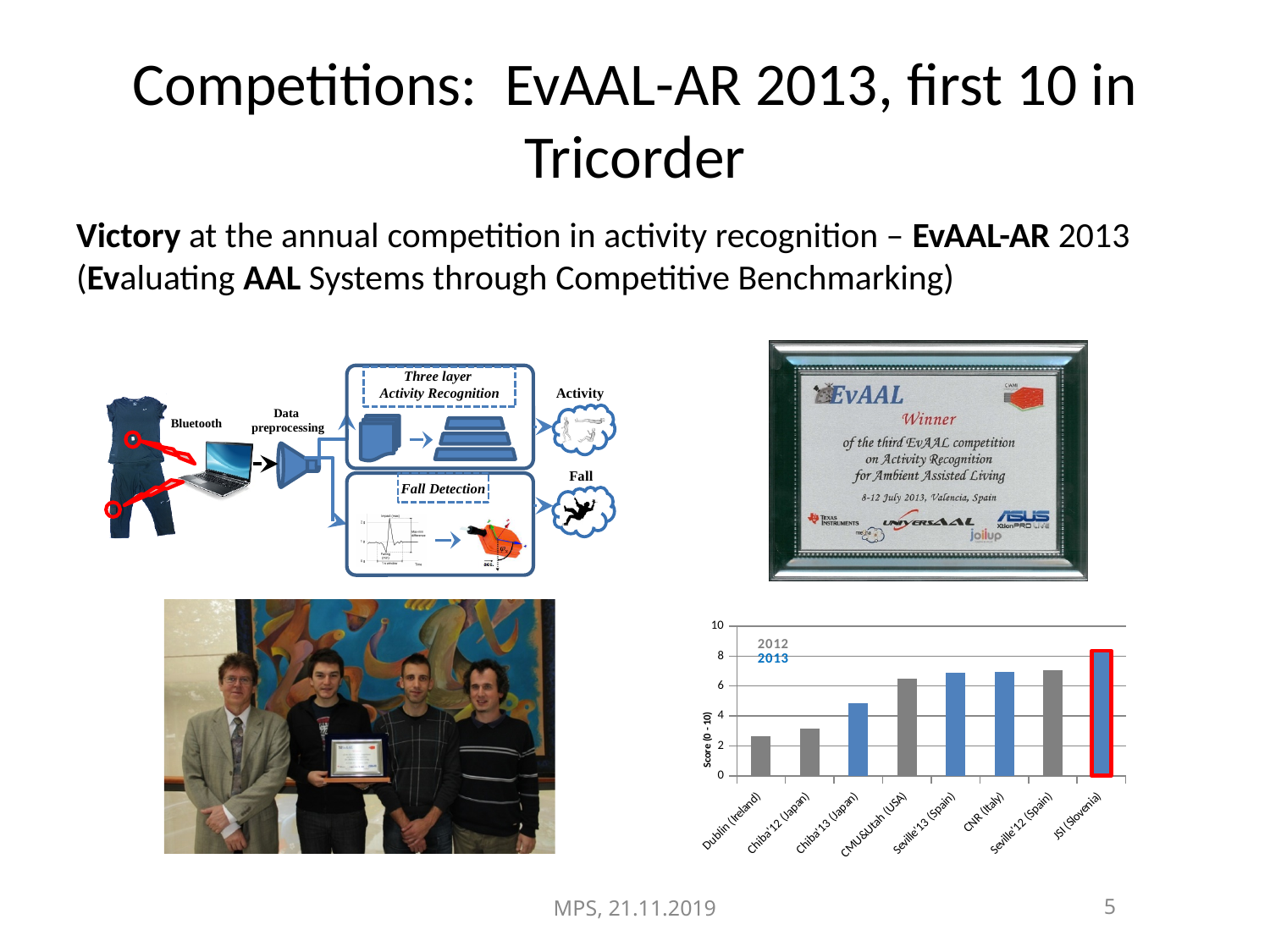
Do the scores in the bar chart rise or fall from left to right along the x axis? rise Which has the higher score, Chiba'13 (Japan) or Chiba'12 (Japan)? Chiba'13 (Japan) What kind of chart is shown at the bottom right of the slide? bar chart Is the score for Dublin (Ireland) greater or less than 4? less Is the score for JSI (Slovenia) greater or less than 8? greater Is the score for CMU&Utah (USA) greater or less than 6? greater What is the label of the y axis of the bar chart? Score (0 - 10) How many categories (teams) are shown on the x axis of the bar chart? 8 Which team has the highest score in the bar chart? JSI (Slovenia) Which team has the lowest score in the bar chart? Dublin (Ireland)